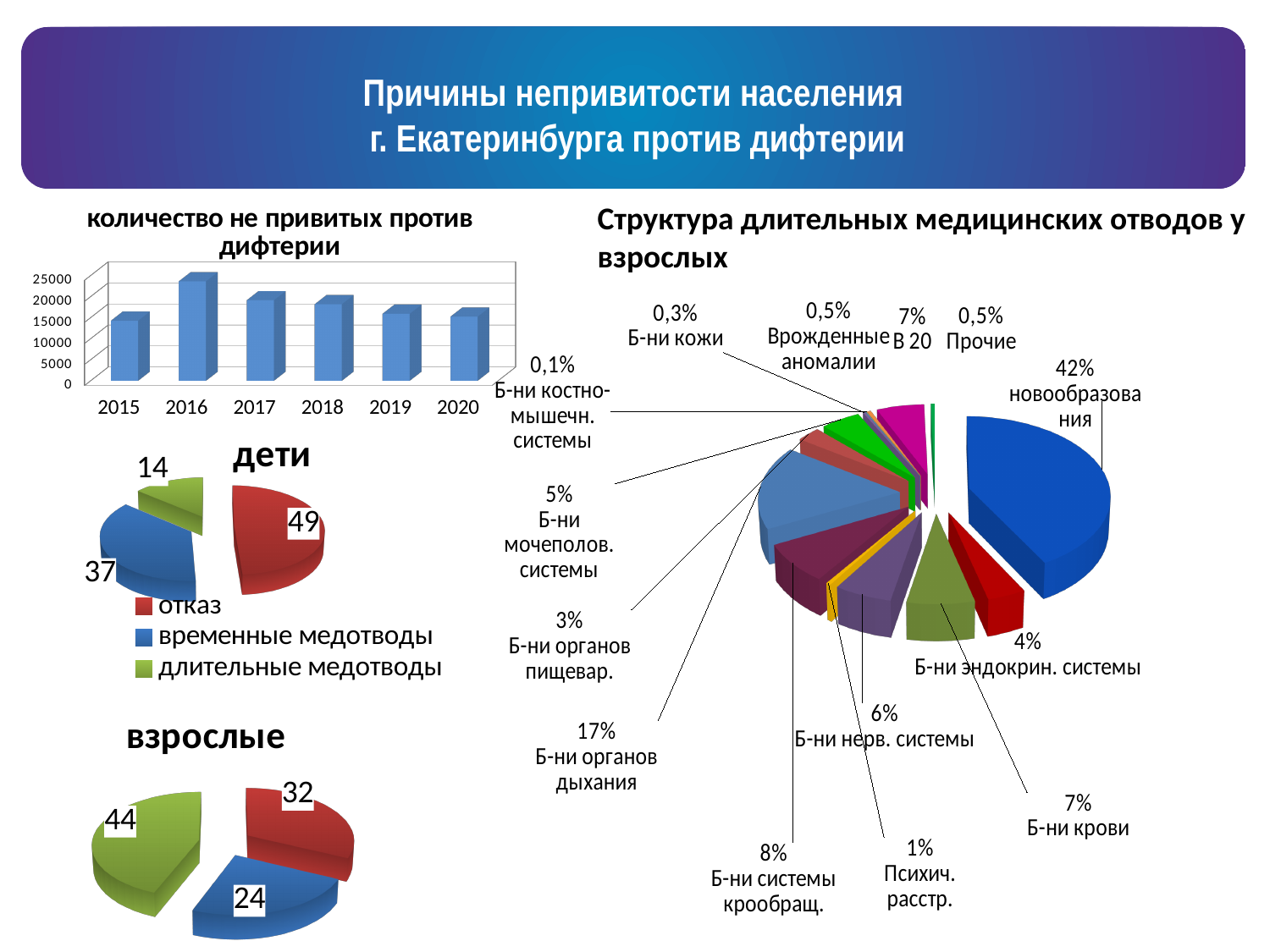
In the pie chart 'дети', what is the value for 'отказ'? 49 In the bar chart 'количество не привитых против дифтерии', is the value for 2015 greater or less than 20000? less In the pie chart 'дети', what is the difference between 'отказ' and 'временные медотводы'? 12 In the pie chart 'взрослые', which category has the largest value? длительные медотводы In the bar chart 'количество не привитых против дифтерии', is the value for 2016 greater or less than 20000? greater In the bar chart 'количество не привитых против дифтерии', which year has the highest value? 2016 In the pie chart 'Структура длительных медицинских отводов у взрослых', what is the share for 'новообразования'? 42% In the pie chart 'дети', which category has the smallest value? длительные медотводы How many years are shown in the bar chart 'количество не привитых против дифтерии'? 6 In the pie chart 'взрослые', what is the value for 'временные медотводы'? 24 What kind of chart is 'количество не привитых против дифтерии'? bar chart In the pie chart 'Структура длительных медицинских отводов у взрослых', which category has the smallest share? Б-ни костно-мышечн. системы